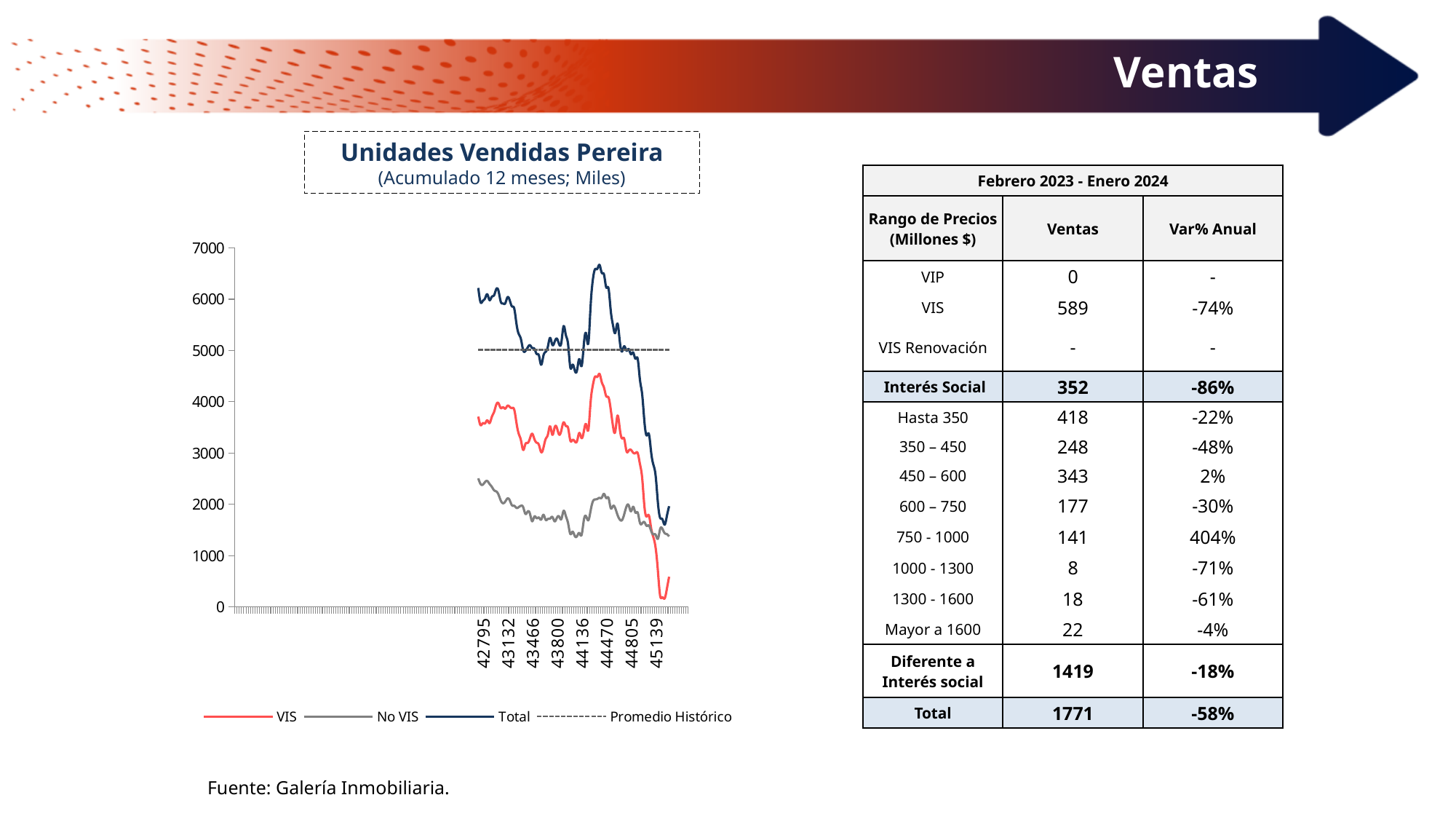
How many series does the chart legend list? 4 Which series has the highest values across most of the period shown? Total Overall, does the Total series rise or fall from the start to the end of the period? fall What is the title of the chart? Unidades Vendidas Pereira What kind of chart is shown on the slide? line chart Which series is drawn as a dashed line in the chart? Promedio Histórico Is the peak value of the VIS series greater or less than 4000? greater Is the peak value of the Total series greater or less than 6000? greater Is the final value of the Total series greater or less than 3000? less At the start of the period, which is larger: the Total series or the No VIS series? Total